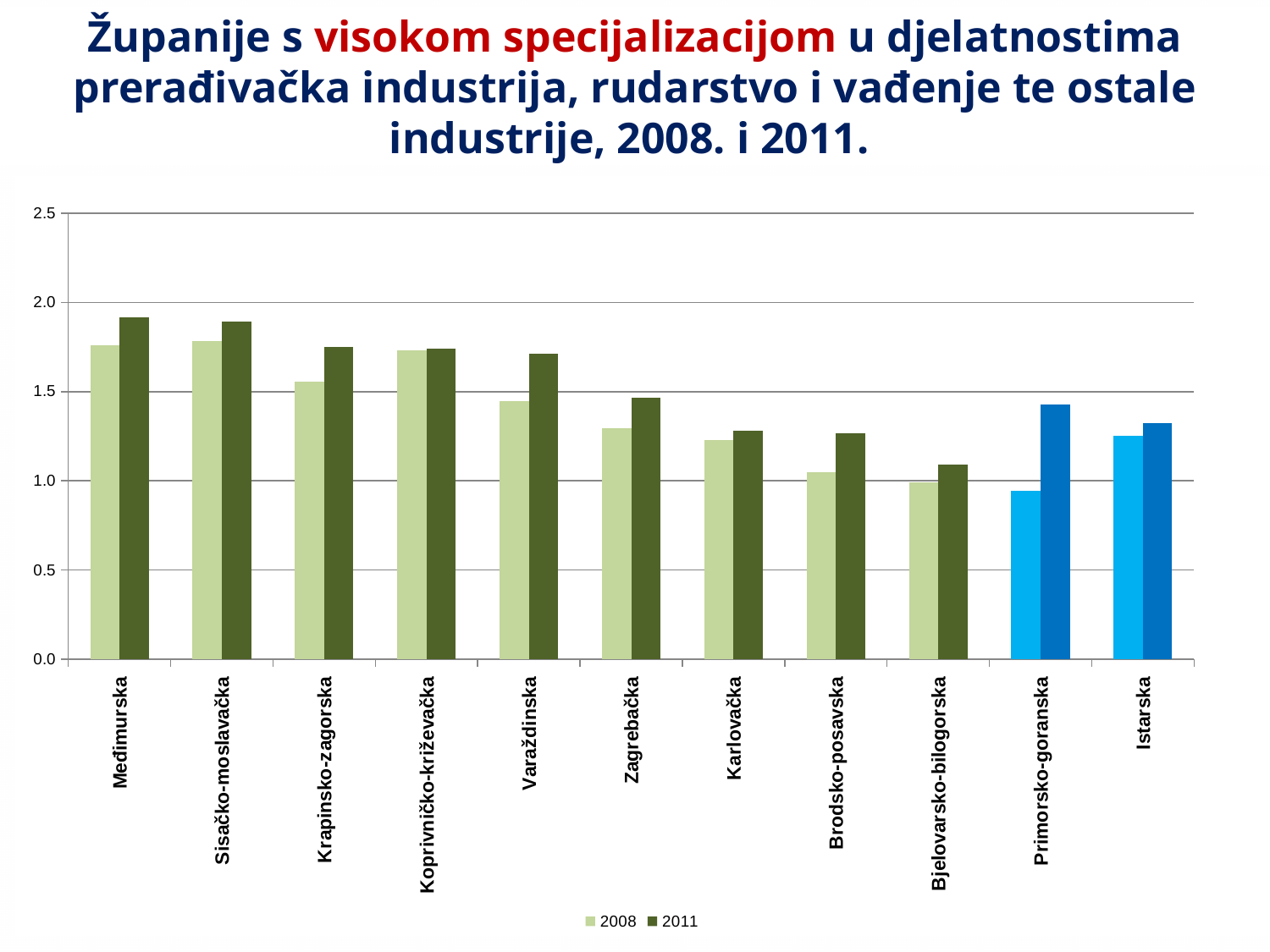
For Primorsko-goranska, which year has the larger value, 2008 or 2011? 2011 How many series does the legend list? 2 Which county has the lowest value for 2011? Bjelovarsko-bilogorska Which two counties are shown with blue bars instead of green? Primorsko-goranska and Istarska Which is larger: the 2008 value for Varaždinska or the 2008 value for Zagrebačka? Varaždinska What are the two series listed in the legend? 2008 and 2011 Is the 2011 value for Varaždinska greater or less than 1.5? greater Is the 2008 value for Zagrebačka greater or less than 1.5? less Is the 2008 value for Krapinsko-zagorska greater or less than 1.5? greater How many counties (categories) are shown on the x axis? 11 What kind of chart is shown on the slide? bar chart